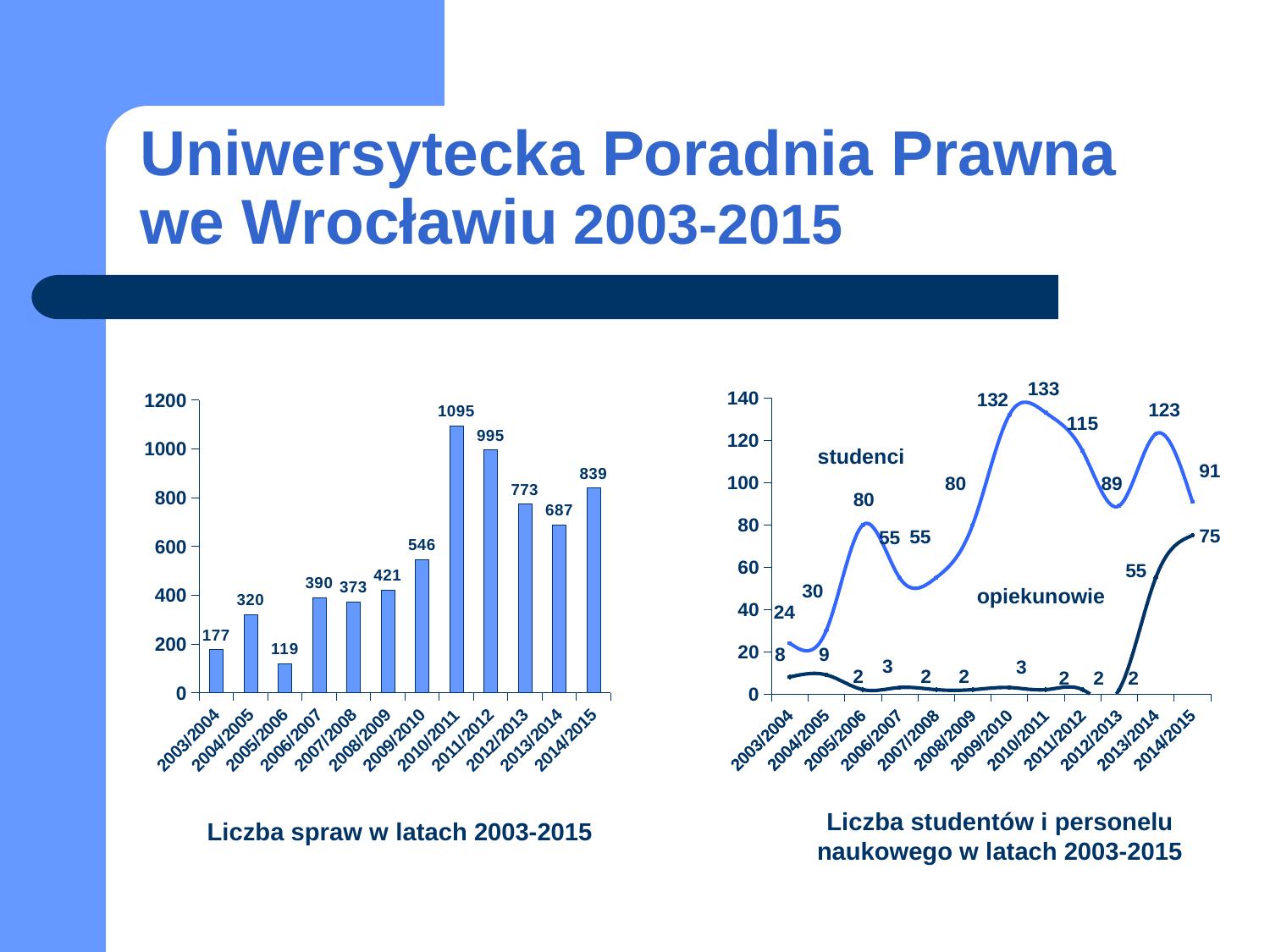
What kind of chart is the left chart (Liczba spraw w latach 2003-2015)? bar chart In the right chart (Liczba studentów i personelu naukowego), which is larger in 2013/2014: studenci or opiekunowie? studenci In the left chart (Liczba spraw w latach 2003-2015), what is the value for 2010/2011? 1095 In the left chart (Liczba spraw w latach 2003-2015), which year has the lowest value? 2005/2006 In the right chart (Liczba studentów i personelu naukowego), what is the value for opiekunowie in 2014/2015? 75 In the left chart (Liczba spraw w latach 2003-2015), how many years are shown on the x axis? 12 In the right chart (Liczba studentów i personelu naukowego), how many series are plotted? 2 In the right chart (Liczba studentów i personelu naukowego), what is the value for studenci in 2009/2010? 132 In the left chart (Liczba spraw w latach 2003-2015), which year has the highest value? 2010/2011 In the right chart (Liczba studentów i personelu naukowego), what is the difference between studenci and opiekunowie in 2003/2004? 16 In the right chart (Liczba studentów i personelu naukowego), in which year does the studenci series reach its highest value? 2010/2011 In the left chart (Liczba spraw w latach 2003-2015), what is the difference between the values for 2014/2015 and 2013/2014? 152